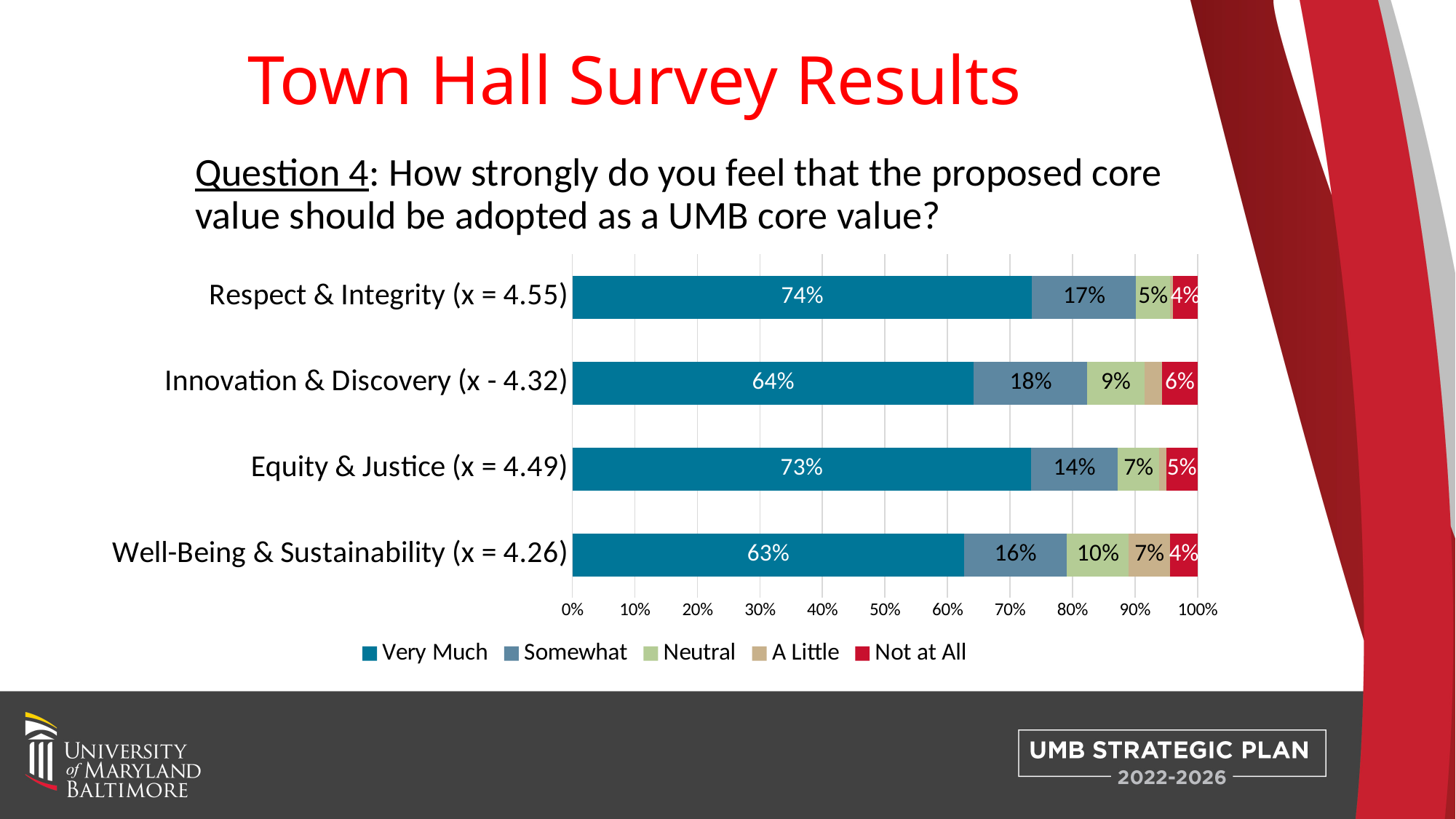
Which core value has the lowest "Very Much" percentage? Well-Being & Sustainability What is the difference between the "Very Much" values for Respect & Integrity and Well-Being & Sustainability? 11% Which core value has the highest "Very Much" percentage? Respect & Integrity What is the total of all segments in the Well-Being & Sustainability bar? 100% How many core values (categories) are shown in the chart? 4 What type of chart is shown on the slide? Stacked bar chart What is the "Neutral" value for Well-Being & Sustainability? 10% What percentage of respondents answered "Very Much" for Respect & Integrity? 74% What is the "Somewhat" value for Innovation & Discovery? 18% Which is larger, the "Somewhat" value for Equity & Justice or for Well-Being & Sustainability? Well-Being & Sustainability How many response options does the legend list? 5 What is the "Not at All" value for Equity & Justice? 5%